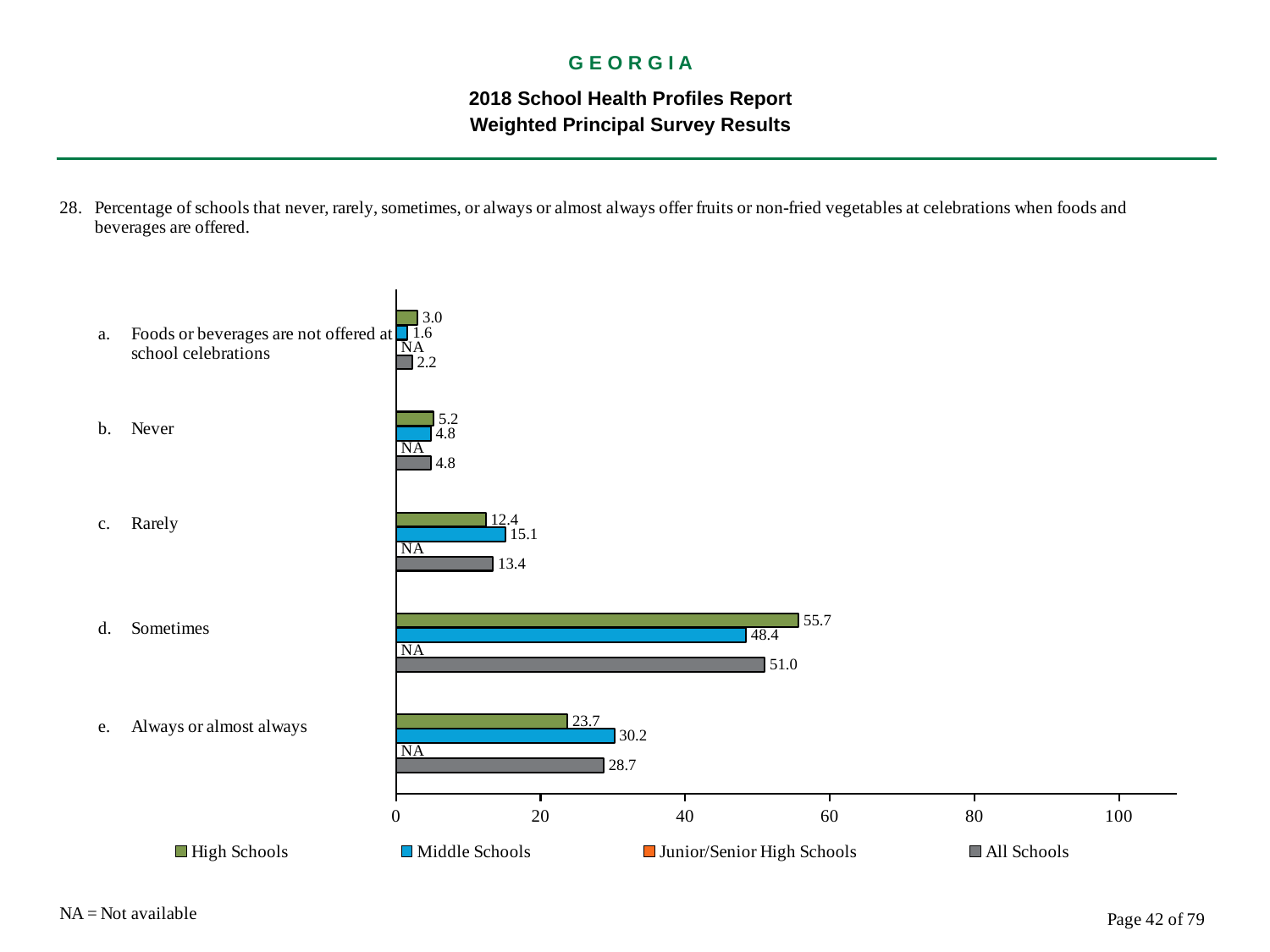
Is the All Schools value for 'Sometimes' greater or less than 40? greater How many categories are shown on the chart? 5 Which category has the highest value for All Schools? Sometimes How many series does the legend list? 4 Which category has the lowest value for Middle Schools? Foods or beverages are not offered at school celebrations What is the value for Middle Schools in the 'Always or almost always' category? 30.2 What is the value for All Schools in the 'Rarely' category? 13.4 What is the value for Junior/Senior High Schools in the 'Never' category? NA What is the value for High Schools in the 'Sometimes' category? 55.7 What kind of chart is shown on the slide? Bar chart What is the difference between the High Schools and Middle Schools values in the 'Sometimes' category? 7.3 In the 'Rarely' category, which is larger: the High Schools value or the Middle Schools value? Middle Schools